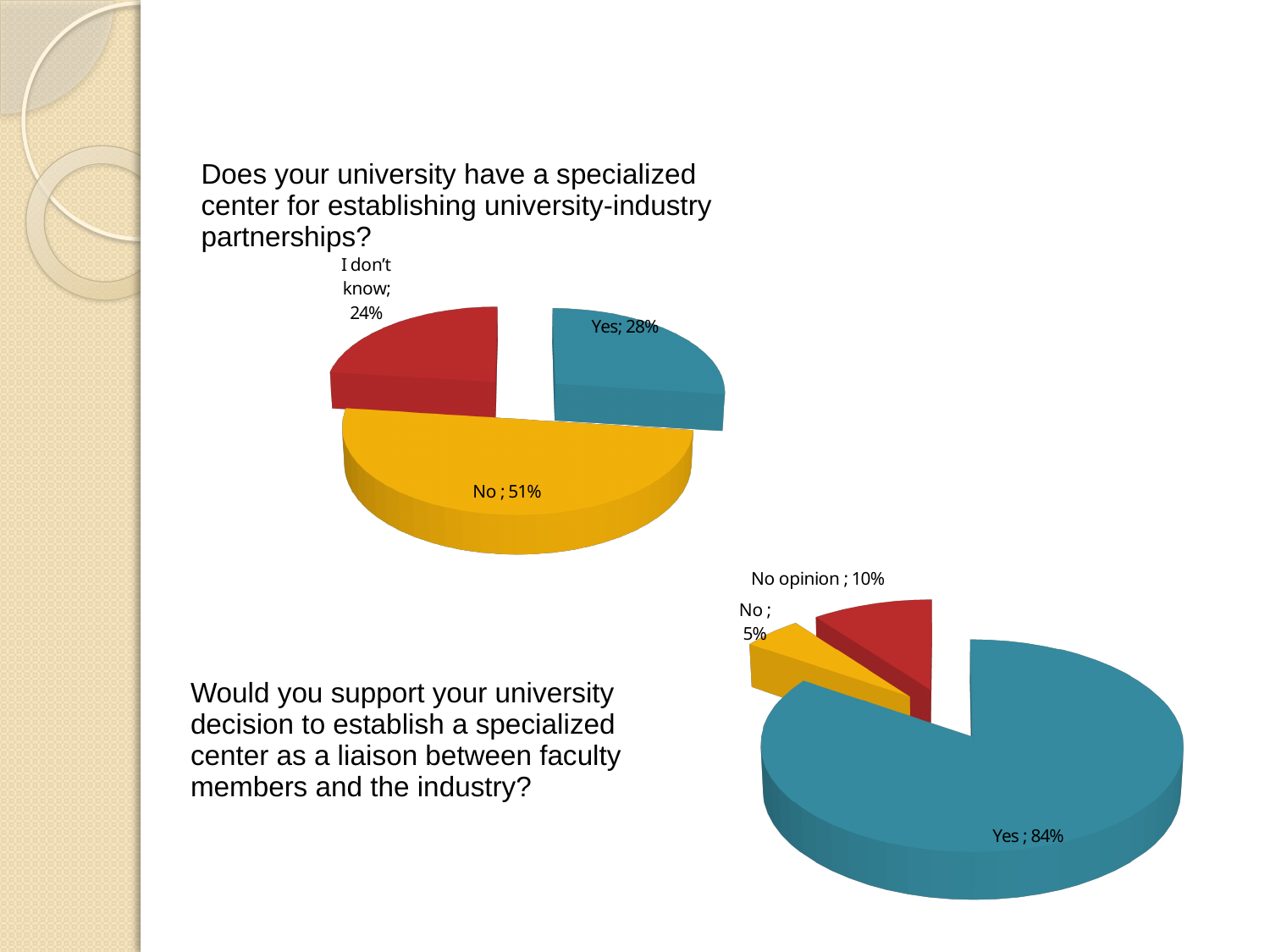
In the top pie chart (specialized center for university-industry partnerships), what is the difference in percentage points between "No" and "Yes"? 23 What type of chart is used for both charts on the slide? Pie chart In the bottom pie chart (support for establishing a liaison center), which is larger, "No" or "No opinion"? No opinion In the bottom pie chart (support for establishing a liaison center), what percentage answered "Yes"? 84% In the top pie chart (specialized center for university-industry partnerships), which response has the largest share? No In the top pie chart (specialized center for university-industry partnerships), which response has the smallest share? I don't know In the top pie chart (specialized center for university-industry partnerships), how many slices are there? 3 In the bottom pie chart (support for establishing a liaison center), what is the difference in percentage points between "Yes" and "No"? 79 In the bottom pie chart (support for establishing a liaison center), which response has the smallest share? No In the bottom pie chart (support for establishing a liaison center), what percentage answered "No opinion"? 10% In the top pie chart (specialized center for university-industry partnerships), what percentage answered "I don't know"? 24% In the top pie chart (specialized center for university-industry partnerships), what percentage answered "No"? 51%